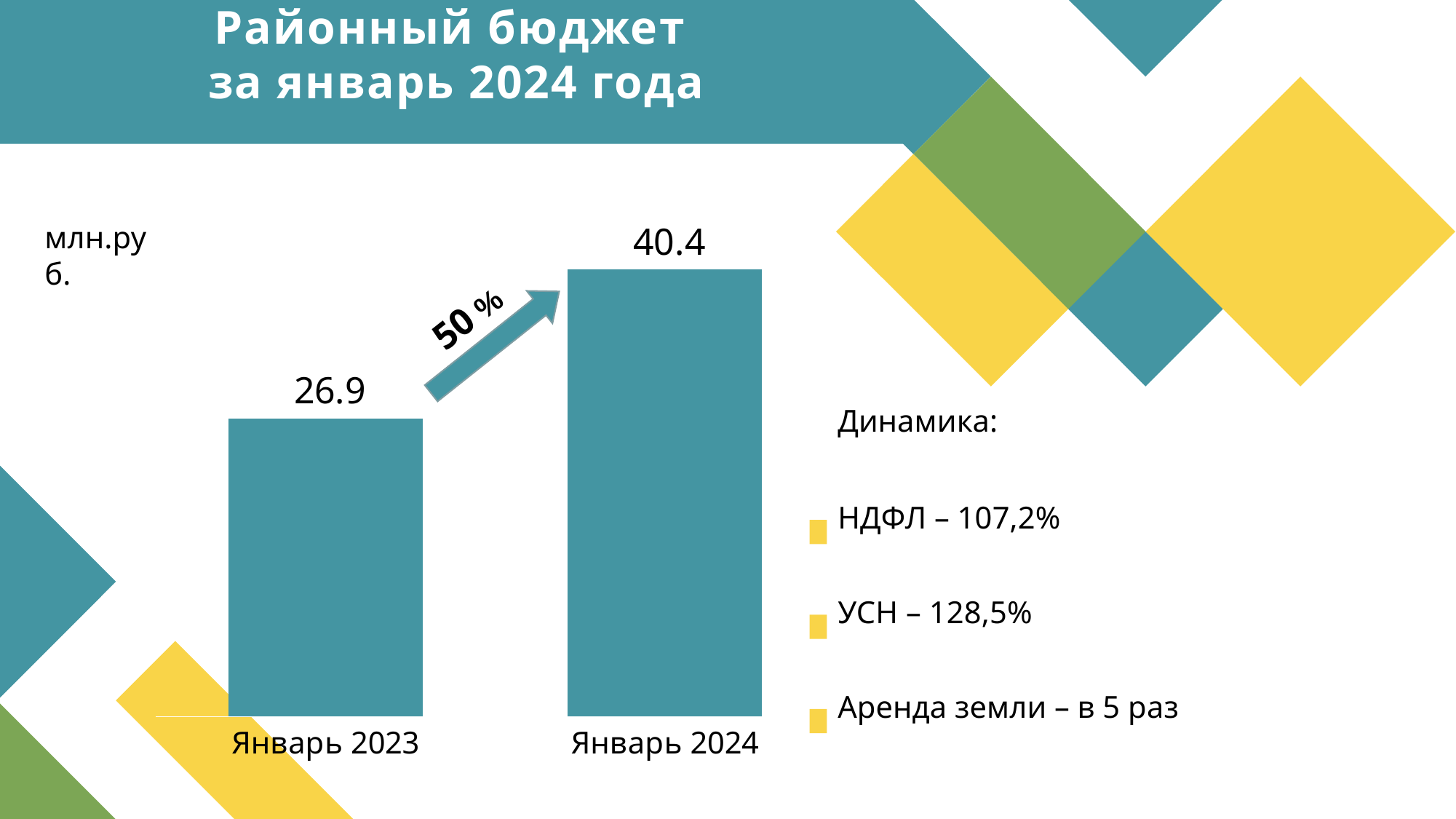
What is the value for Январь 2023? 26.9 What kind of chart is shown on the slide? bar chart Do the values rise or fall from Январь 2023 to Январь 2024? rise How many bars are plotted in the chart? 2 What is the value for Январь 2024? 40.4 Which category has the highest value? Январь 2024 What unit is indicated for the chart values? млн.руб. Which category has the lowest value? Январь 2023 Which is larger, the value for Январь 2023 or Январь 2024? Январь 2024 What is the difference between the values for Январь 2024 and Январь 2023? 13.5 What percentage growth is shown on the arrow between the two bars? 50 %